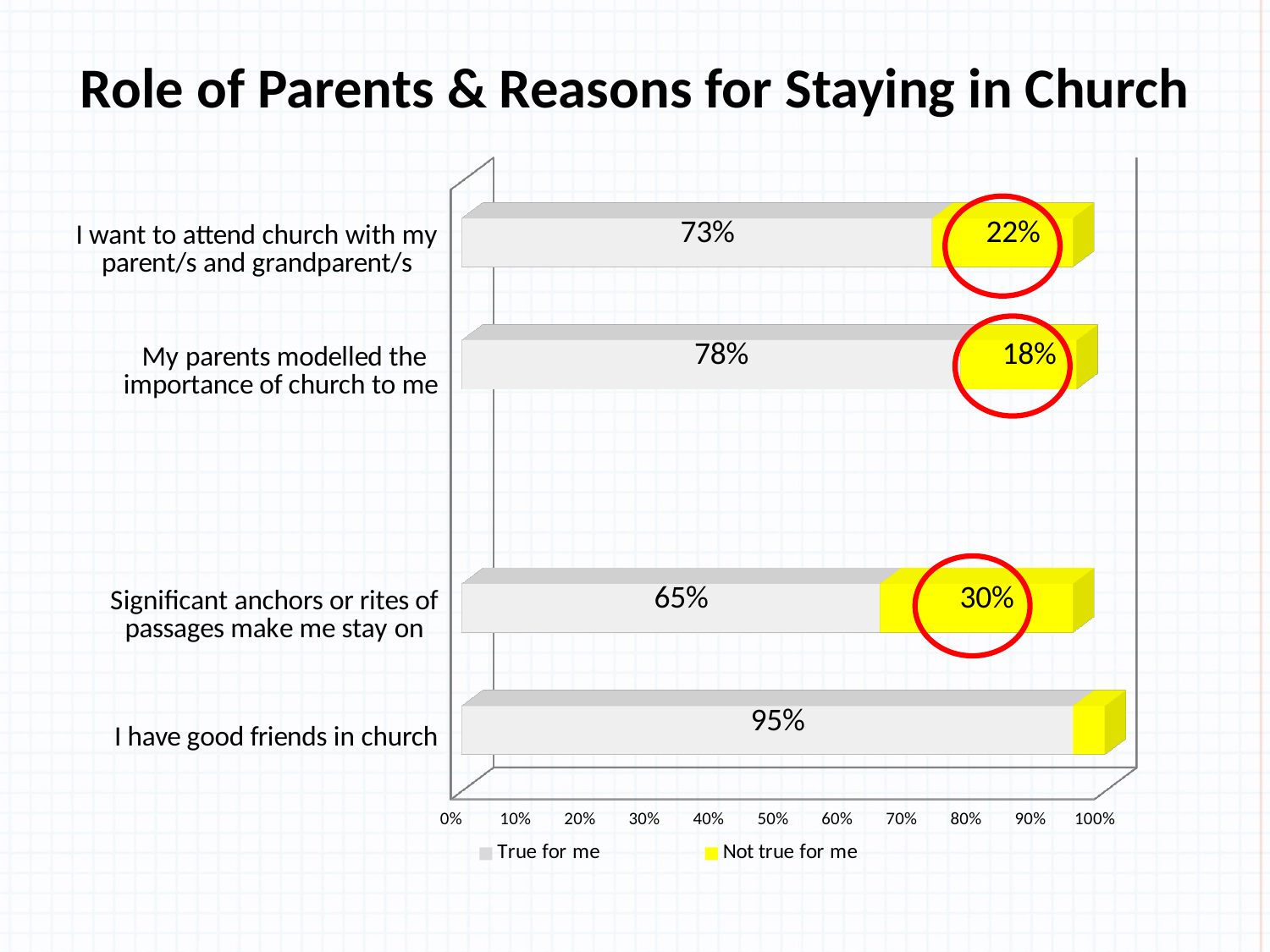
How many series does the legend list? 2 What is the "Not true for me" value for "Significant anchors or rites of passages make me stay on"? 30% Which category has the highest "True for me" value? I have good friends in church How many categories are shown in the chart? 4 What percentage of respondents said "True for me" for "I have good friends in church"? 95% What is the "True for me" value for "My parents modelled the importance of church to me"? 78% Which is larger: the "Not true for me" value for "My parents modelled the importance of church to me" or for "I want to attend church with my parent/s and grandparent/s"? I want to attend church with my parent/s and grandparent/s What is the combined total of the "True for me" and "Not true for me" values for "My parents modelled the importance of church to me"? 96% Which category has the lowest "True for me" value? Significant anchors or rites of passages make me stay on What kind of chart is shown on the slide? Stacked bar chart What is the "Not true for me" value for "I want to attend church with my parent/s and grandparent/s"? 22% What is the difference between the "True for me" values for "I have good friends in church" and "Significant anchors or rites of passages make me stay on"? 30%